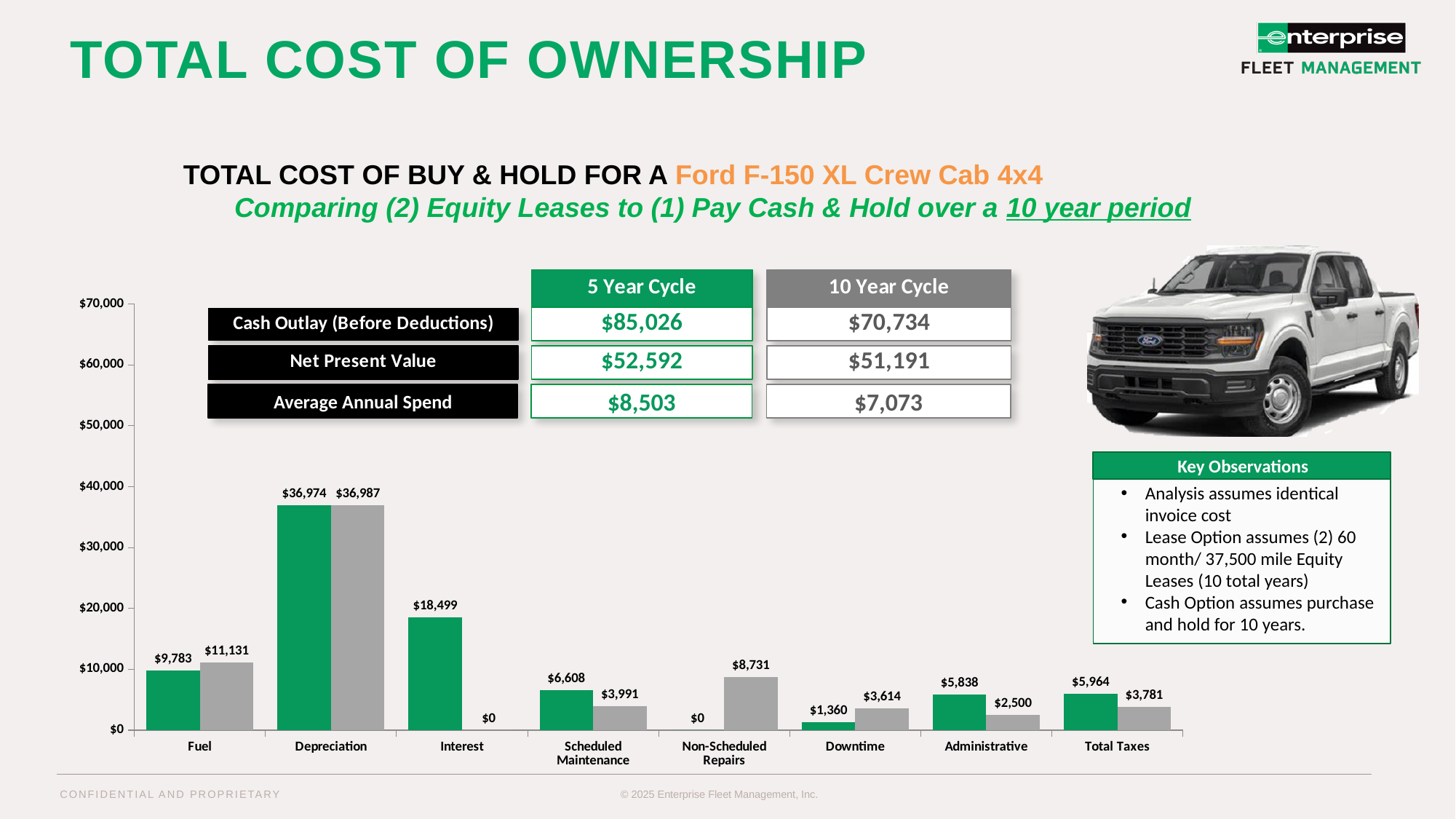
What kind of chart is shown on the slide? Bar chart Which category has the lowest gray bar? Interest What is the difference between the green bar and the gray bar for Administrative? $3,338 For Scheduled Maintenance, which is larger: the green bar or the gray bar? The green bar What is the value of the green bar for Interest? $18,499 How many cost categories are shown along the x axis of the chart? 8 What is the label of the first category on the x axis of the chart? Fuel Which category has the highest green bar? Depreciation What is the value of the gray bar for Non-Scheduled Repairs? $8,731 What is the value of the gray bar for Downtime? $3,614 What is the value of the green bar for Fuel? $9,783 What is the difference between the gray bar and the green bar for Fuel? $1,348